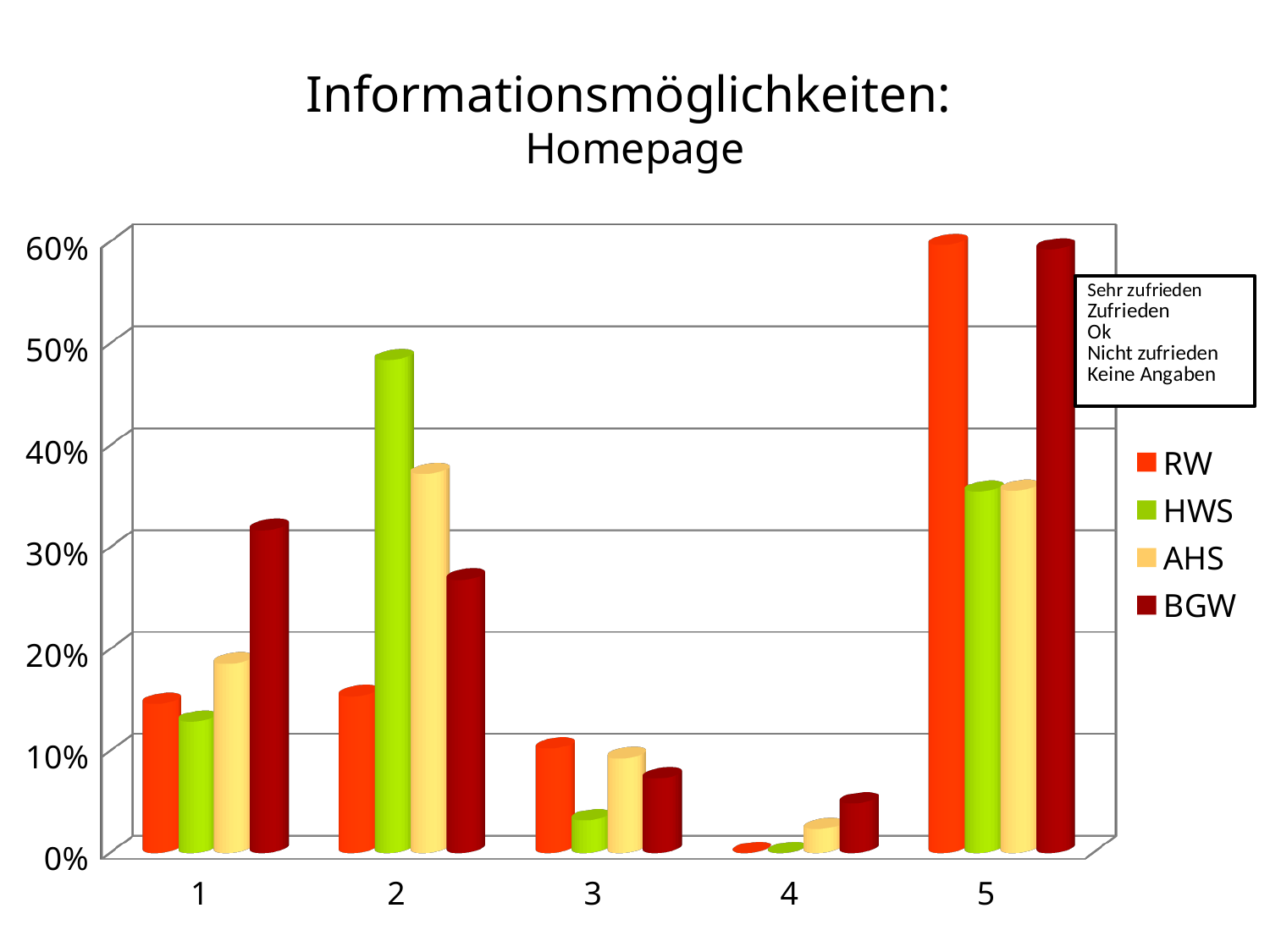
How many categories are shown on the x axis? 5 Which category has the lowest value for AHS? 4 In category 1, which is larger: BGW or RW? BGW Which category has the highest value for BGW? 5 In category 2, which is larger: HWS or AHS? HWS What is the title of the chart? Informationsmöglichkeiten: Homepage What kind of chart is shown on the slide? bar chart Which category has the highest value for HWS? 2 How many series does the legend list? 4 In category 3, which is larger: RW or HWS? RW Is the value for BGW in category 1 greater or less than 20%? greater Is the value for HWS in category 2 greater or less than 40%? greater